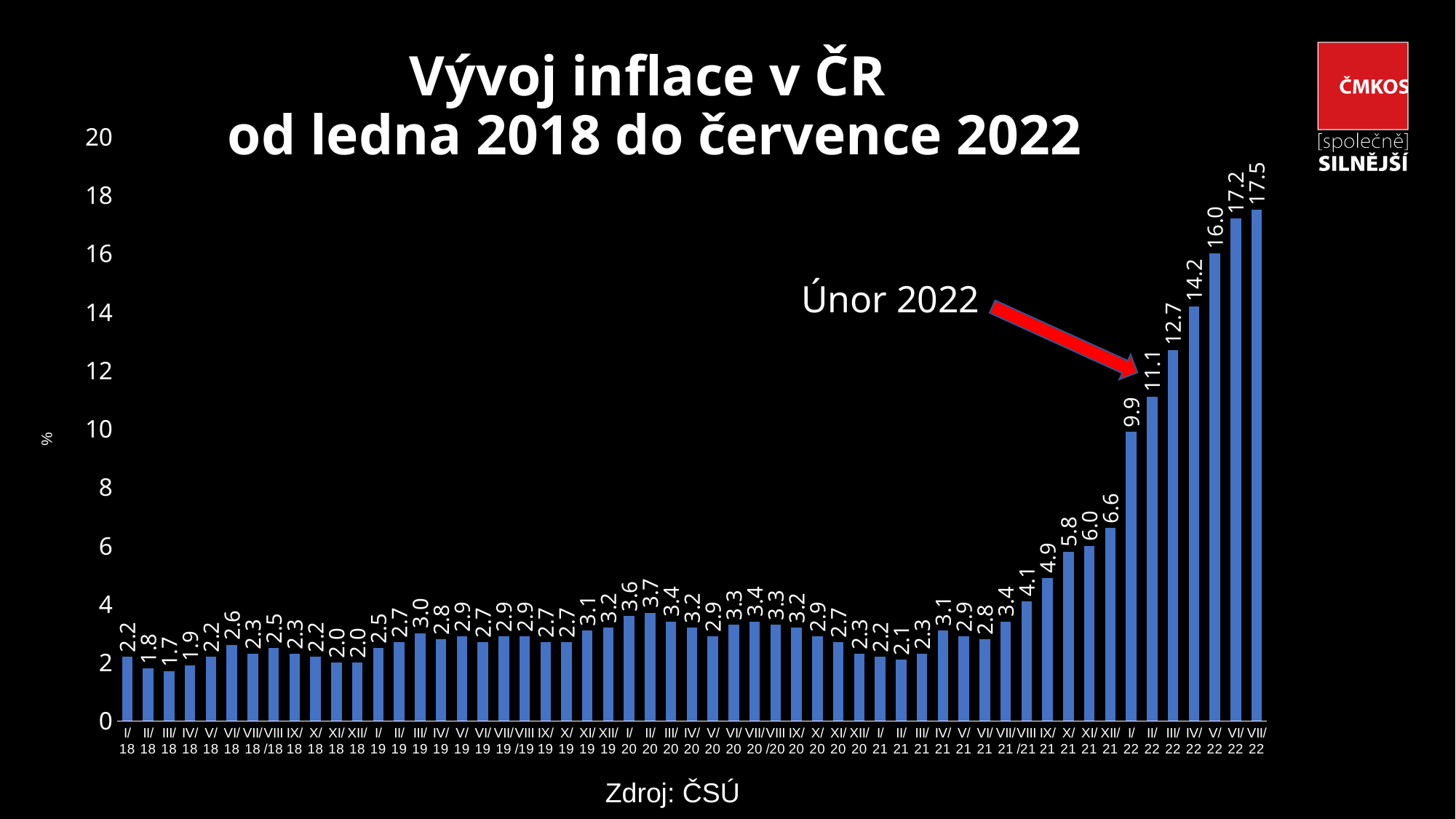
What is the inflation value for VII/22? 17.5 Do the values rise or fall from I/22 to VII/22? rise What kind of chart is shown on the slide? bar chart Which month has the lowest inflation value? III/18 What is the difference between the values for VII/22 and I/22? 7.6 Which is larger, the value for II/20 or the value for XII/21? XII/21 Is the value for III/22 greater or less than 12? greater What is the difference between the values for V/22 and IV/22? 1.8 How many monthly bars are plotted on the chart? 55 What is the inflation value for I/22? 9.9 What is the inflation value for II/22, the month marked 'Únor 2022'? 11.1 Which month has the highest inflation value? VII/22